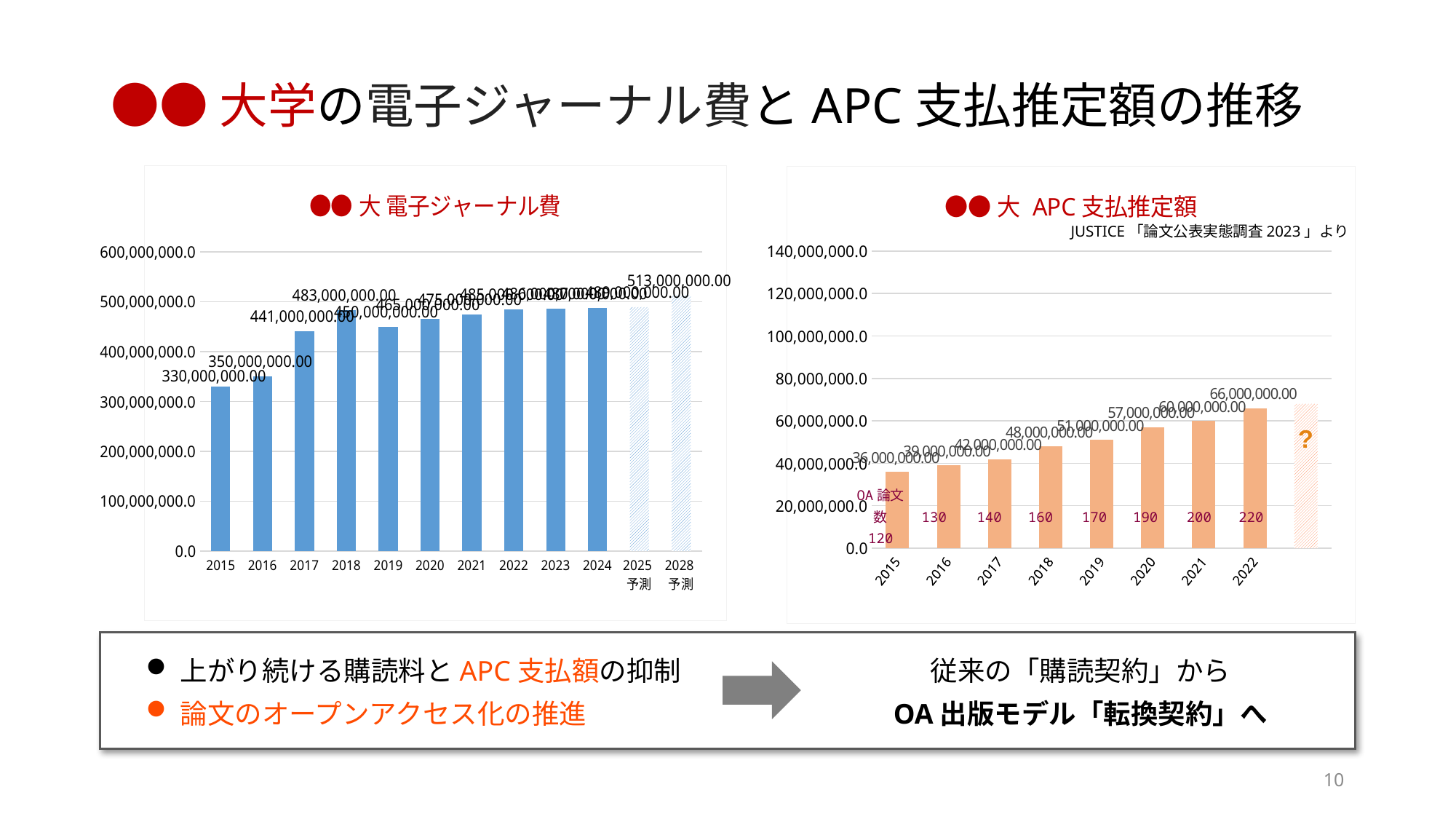
In the left chart (●● 大 電子ジャーナル費), do the values generally rise or fall from 2015 to 2024? rise What kind of chart is the left chart titled ●● 大 電子ジャーナル費? bar chart In the right chart (●● 大 APC 支払推定額), what is the difference between the 2022 and 2015 values? 30,000,000.00 In the left chart (●● 大 電子ジャーナル費), is the value for 2019 greater or less than 400,000,000.0? greater In the left chart (●● 大 電子ジャーナル費), what is the value for 2028 予測? 513,000,000.00 In the right chart (●● 大 APC 支払推定額), which year has the highest labeled value? 2022 In the left chart (●● 大 電子ジャーナル費), what is the value for 2015? 330,000,000.00 In the right chart (●● 大 APC 支払推定額), what is the value for 2022? 66,000,000.00 In the left chart (●● 大 電子ジャーナル費), what is the difference between the 2016 and 2015 values? 20,000,000.00 In the right chart (●● 大 APC 支払推定額), what is the value for 2015? 36,000,000.00 In the right chart (●● 大 APC 支払推定額), what is the OA 論文数 shown for 2022? 220 In the right chart (●● 大 APC 支払推定額), how many years with labeled values are shown on the x axis? 8